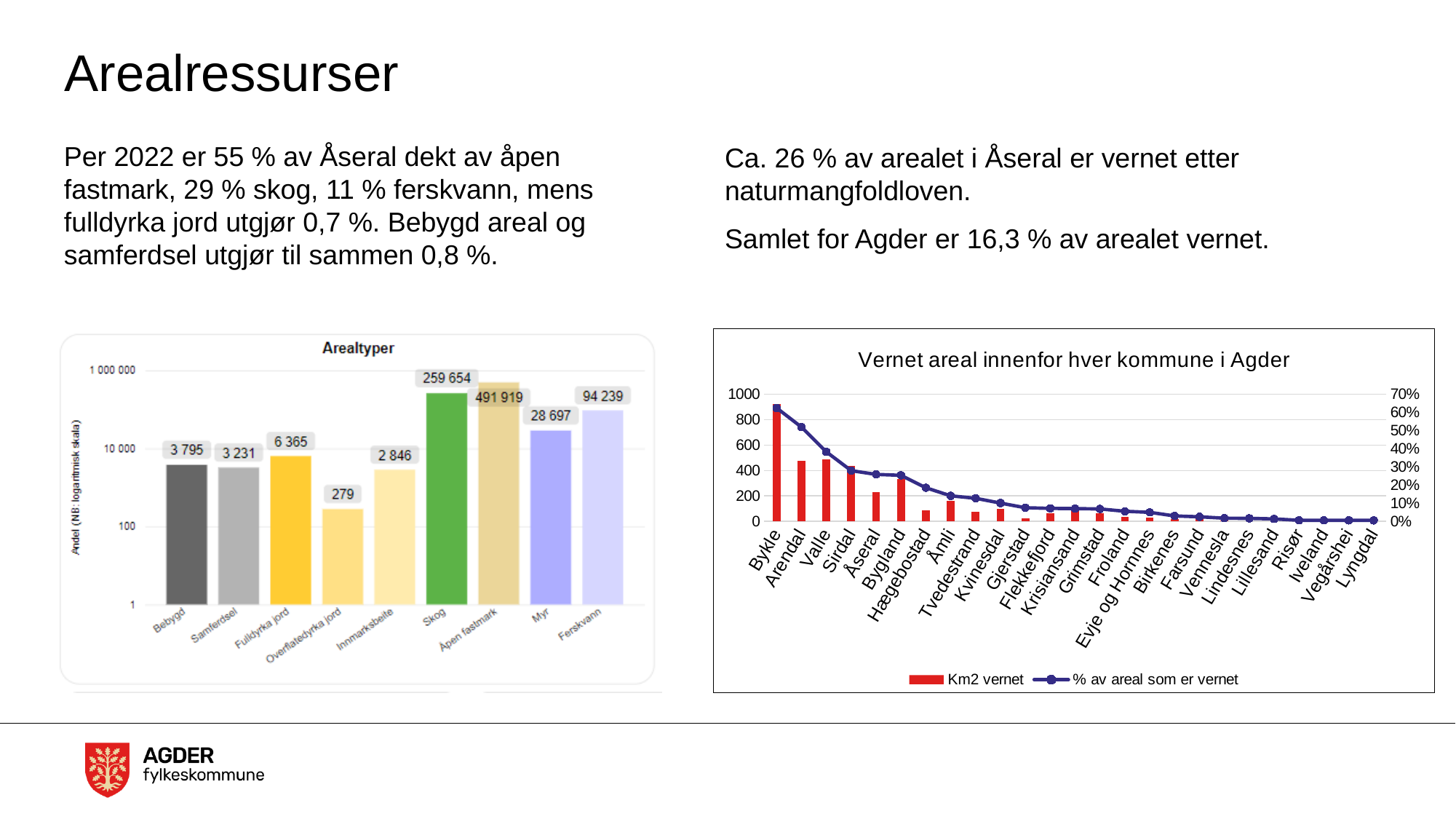
In the Arealtyper chart, what is the value for Ferskvann? 94 239 In the chart 'Vernet areal innenfor hver kommune i Agder', does the '% av areal som er vernet' line rise or fall from left to right? fall In the Arealtyper chart, what is the value for Overflatedyrka jord? 279 In the Arealtyper chart, which category has the lowest value? Overflatedyrka jord How many series does the legend list in the chart 'Vernet areal innenfor hver kommune i Agder'? 2 How many categories are shown in the Arealtyper chart? 9 In the Arealtyper chart, what is the difference between Bebygd and Samferdsel? 564 In the chart 'Vernet areal innenfor hver kommune i Agder', is the Km2 vernet value for Bykle greater or less than 800? greater In the Arealtyper chart, which is larger, Fulldyrka jord or Innmarksbeite? Fulldyrka jord In the Arealtyper chart, what is the value for Skog? 259 654 In the Arealtyper chart, which category has the highest value? Åpen fastmark In the chart 'Vernet areal innenfor hver kommune i Agder', which municipality has the highest Km2 vernet? Bykle